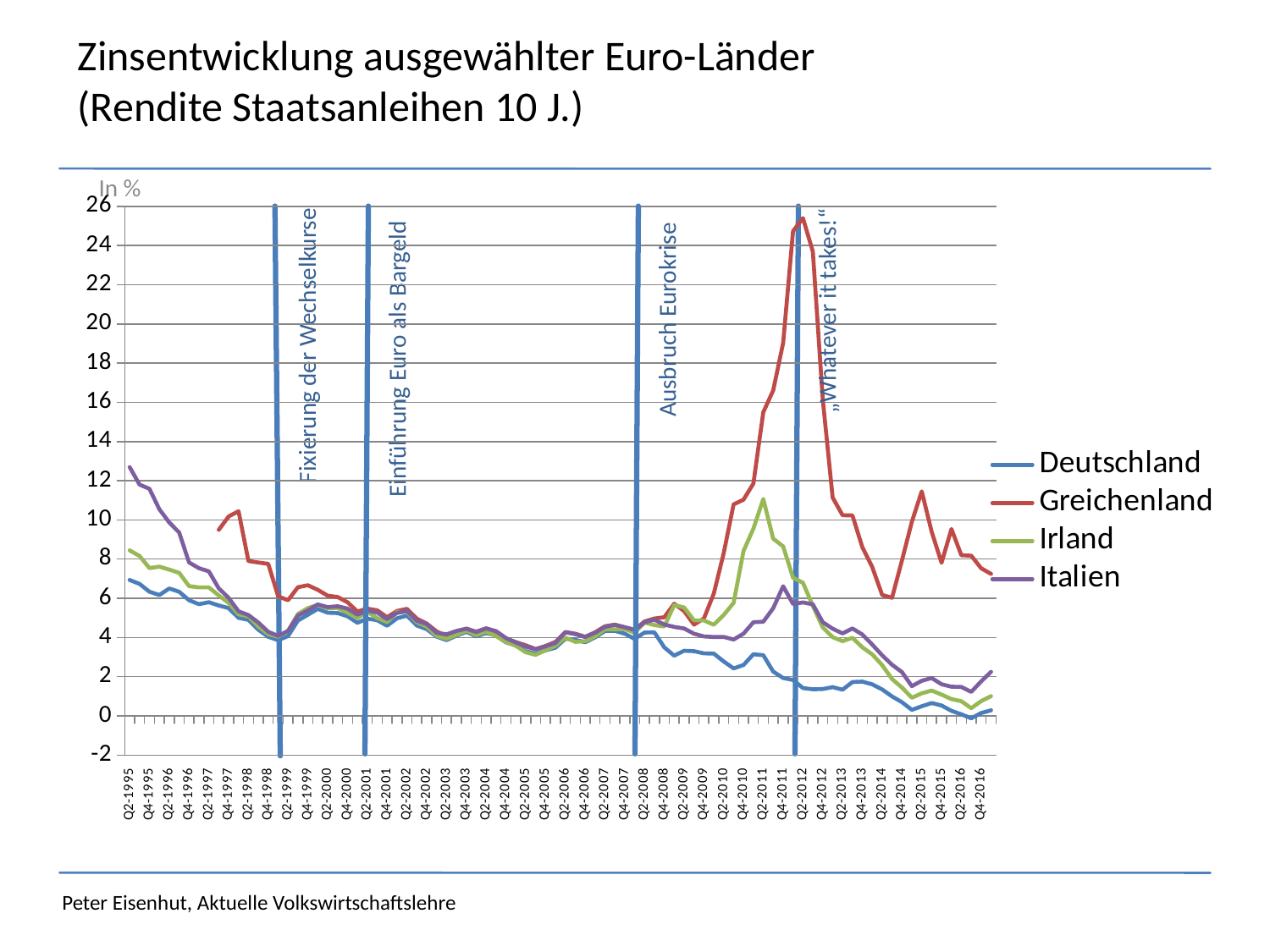
Which series has the lowest value at Q4-2016? Deutschland Is the value for Deutschland at Q4-2016 greater or less than 2? less At Q2-1995, which is larger: the value for Italien or the value for Deutschland? Italien Is the value for Italien at Q2-1995 greater or less than 10? greater Is the peak value of the Irland series around 2011 greater or less than 8? greater Which series are listed in the legend? Deutschland, Greichenland, Irland, Italien Does the Deutschland series overall rise or fall from Q2-1995 to Q4-2016? fall What is the title of the chart on the slide? Zinsentwicklung ausgewählter Euro-Länder (Rendite Staatsanleihen 10 J.) How many series does the legend list? 4 Which series reaches the highest value anywhere on the chart? Greichenland What kind of chart is shown on the slide? line chart